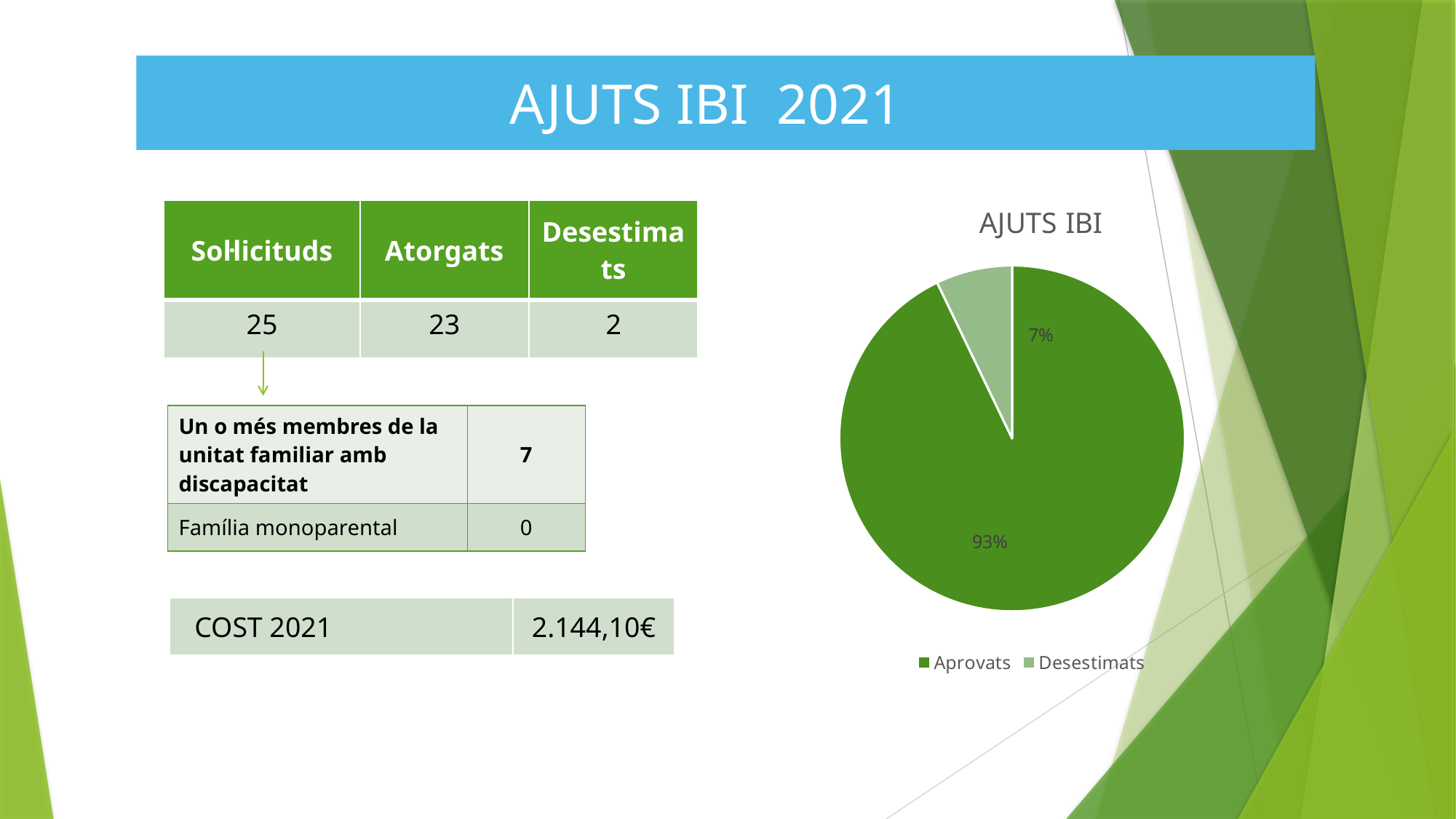
Which slice of the pie is the largest? Aprovats Which legend entry is shown in the lighter green colour? Desestimats How many slices does the pie chart have? 2 What is the difference in percentage points between the Aprovats and Desestimats slices? 86 What is the title of the chart? AJUTS IBI What share of the pie does Aprovats represent? 93% How many entries does the legend list? 2 What type of chart is shown on the slide? pie chart Which is larger, the Aprovats slice or the Desestimats slice? Aprovats What share of the pie does Desestimats represent? 7% Which slice of the pie is the smallest? Desestimats